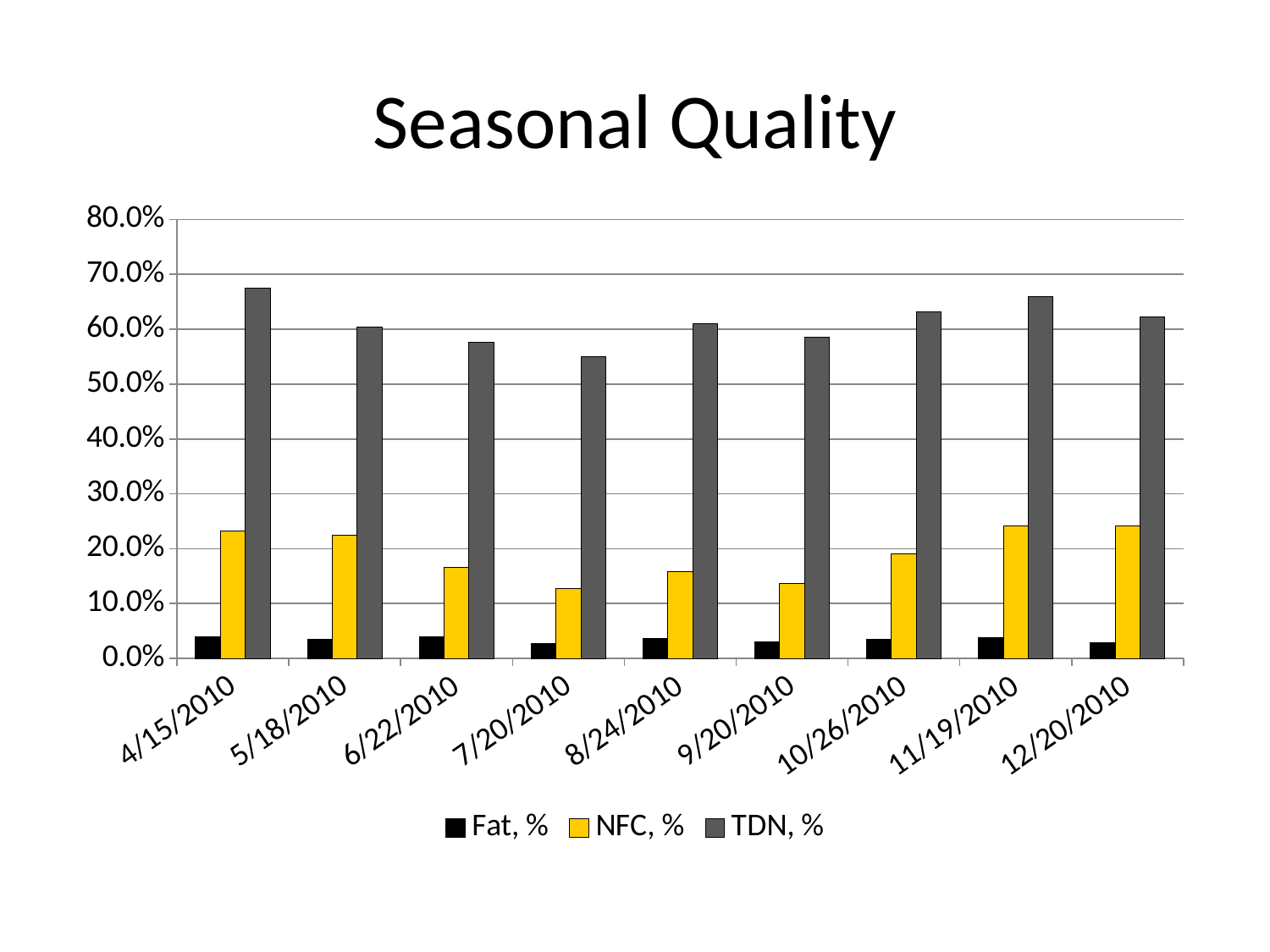
Is the TDN, % value for 7/20/2010 greater or less than 60.0%? less Is the TDN, % value for 4/15/2010 greater or less than 60.0%? greater Which is larger, the NFC, % value for 4/15/2010 or for 7/20/2010? 4/15/2010 Is the NFC, % value for 4/15/2010 greater or less than 20.0%? greater On which date is TDN, % highest? 4/15/2010 On which date is TDN, % lowest? 7/20/2010 What is the title of the chart? Seasonal Quality How many series does the legend list? 3 How many dates are shown on the x axis? 9 Which series is shown in yellow? NFC, % What kind of chart is shown on the slide? bar chart